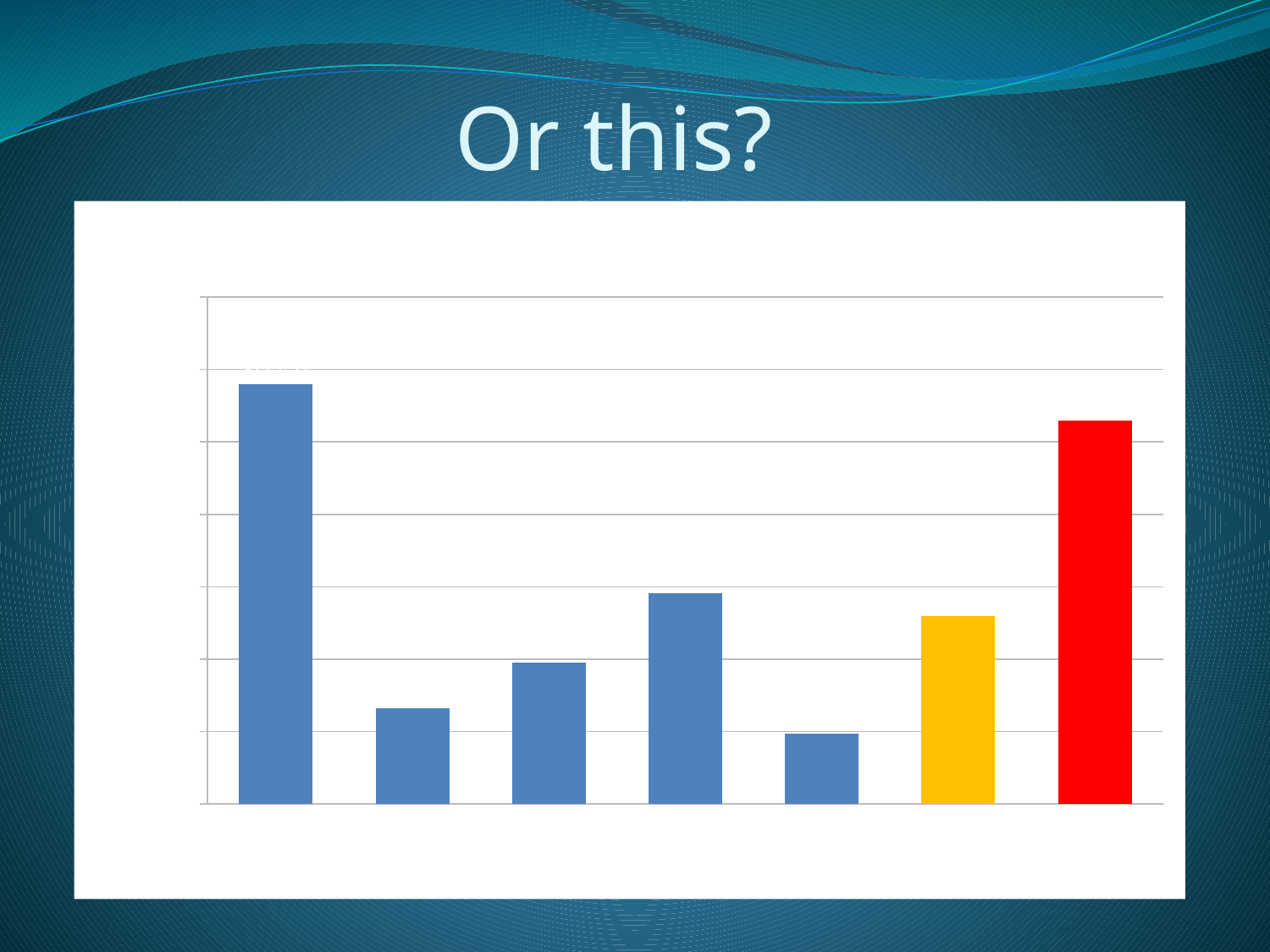
Which bar is the tallest in the chart? the first bar (leftmost, blue) Which bar is the shortest in the chart? the fifth bar (blue) What colour is the sixth bar in the chart? yellow What kind of chart is shown on the slide? bar chart Which is taller, the first bar or the red bar? the first bar Which is taller, the red bar or the yellow bar? the red bar Which is taller, the second bar or the fourth bar? the fourth bar How many bars does the chart contain? 7 Does the chart show a legend? no What colour is the rightmost bar in the chart? red